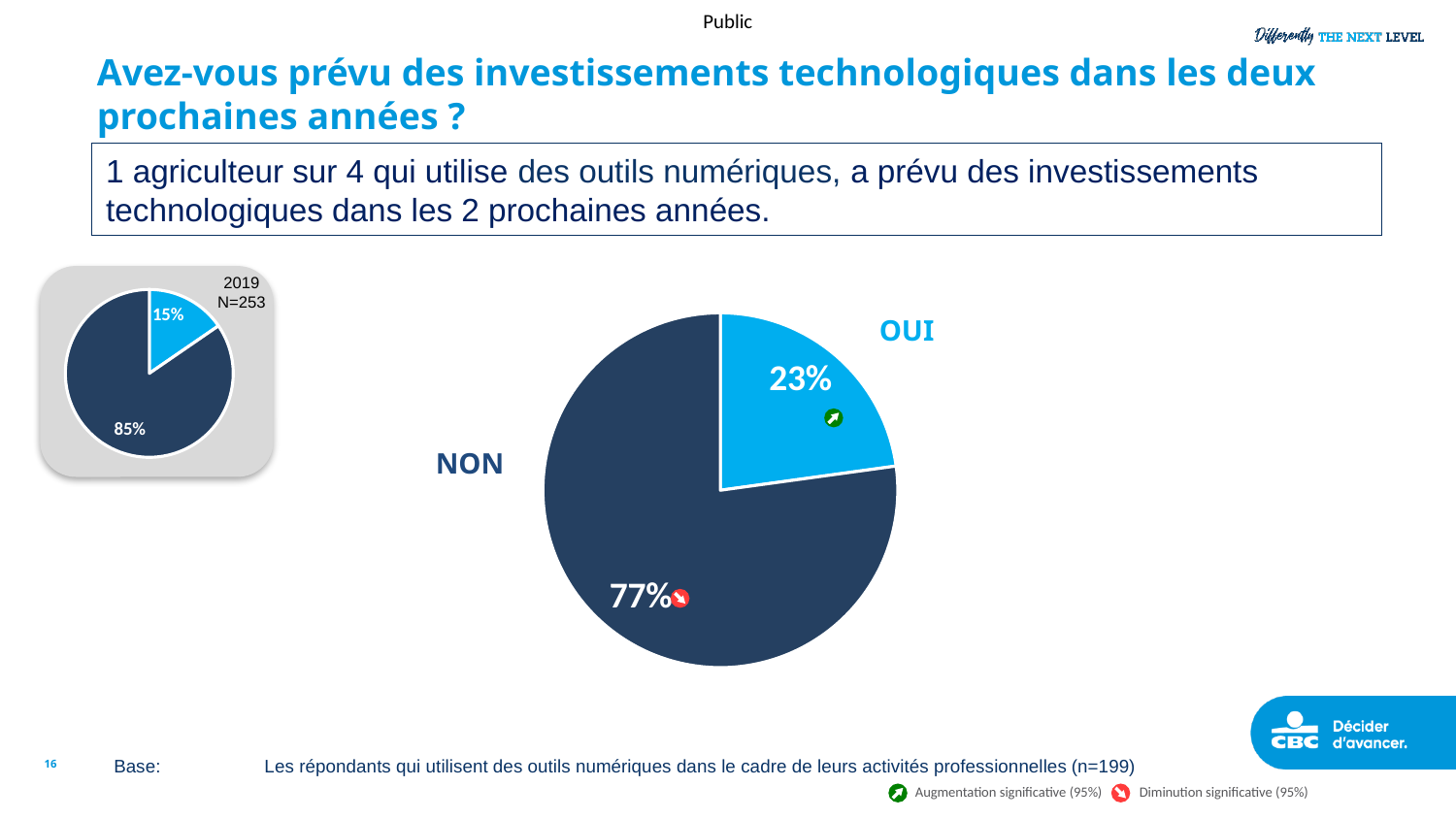
In the large pie chart, what percentage of respondents answered OUI? 23% What sample size (N) is shown next to the small pie chart on the left? N=253 In the large pie chart, is the share for OUI greater or less than 25%? less In the large pie chart, what percentage of respondents answered NON? 77% In the small pie chart on the left (2019), what is the value of the dark blue slice? 85% In the large pie chart, which answer has the larger share, OUI or NON? NON In the small pie chart on the left (2019), what is the value of the light blue slice? 15% How many slices does the large pie chart have? 2 What kind of chart is the large chart in the centre of the slide? Pie chart In the large pie chart, what is the difference in percentage points between NON and OUI? 54 Which year is labelled on the small pie chart on the left? 2019 In the small pie chart on the left (2019), which slice is the smallest? The light blue slice (15%)